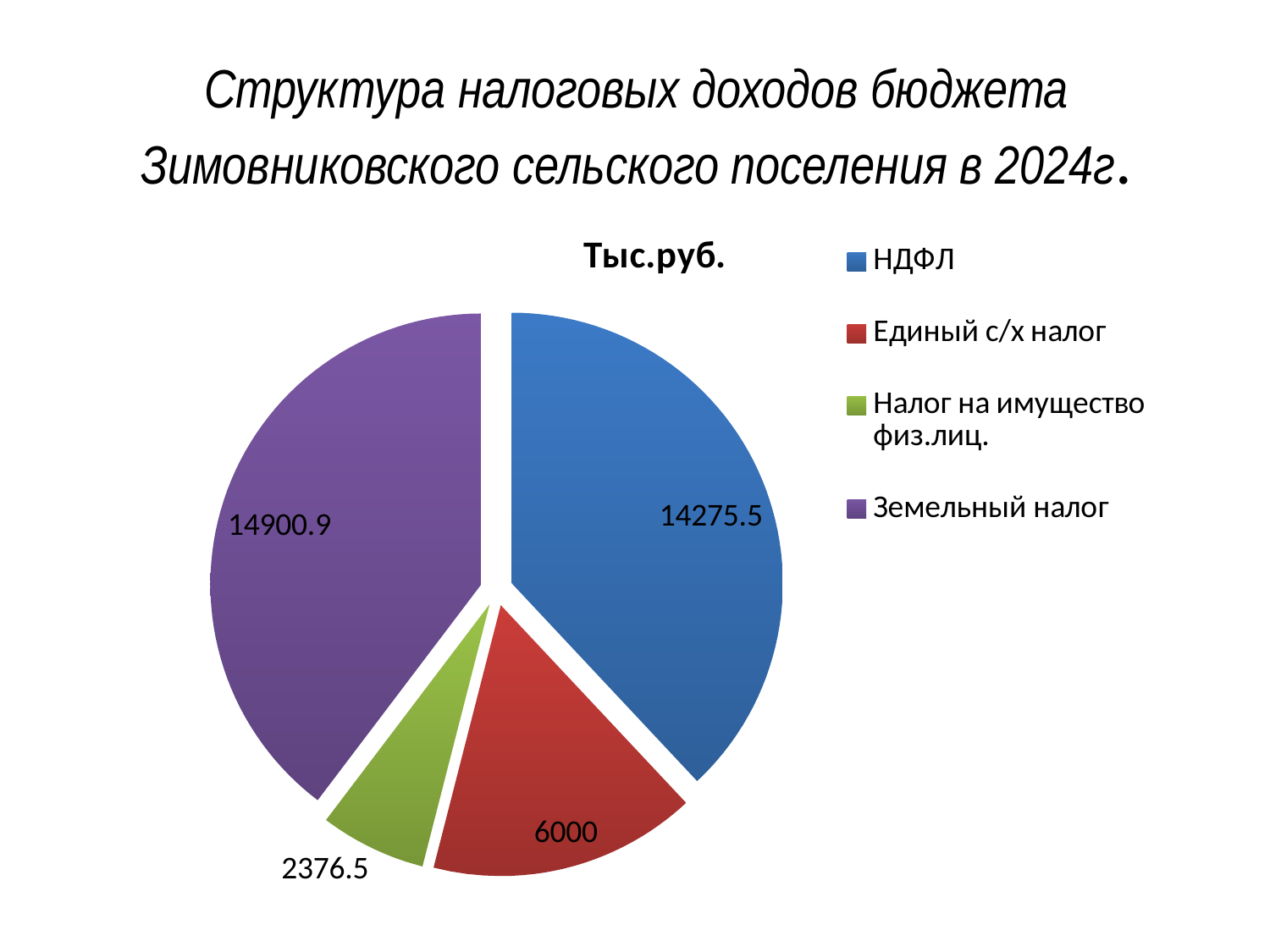
Which is larger, the value for Единый с/х налог or the value for Налог на имущество физ.лиц.? Единый с/х налог What type of chart is shown on the slide? pie chart Which category has the largest value? Земельный налог What is the difference between the values for Единый с/х налог and Налог на имущество физ.лиц.? 3623.5 What is the value for Единый с/х налог? 6000 What is the difference between the values for Земельный налог and НДФЛ? 625.4 What is the value for НДФЛ? 14275.5 How many categories does the pie chart have? 4 What is the value for Земельный налог? 14900.9 What is the value for Налог на имущество физ.лиц.? 2376.5 What unit label is shown above the pie chart? Тыс.руб. Which category has the smallest value? Налог на имущество физ.лиц.